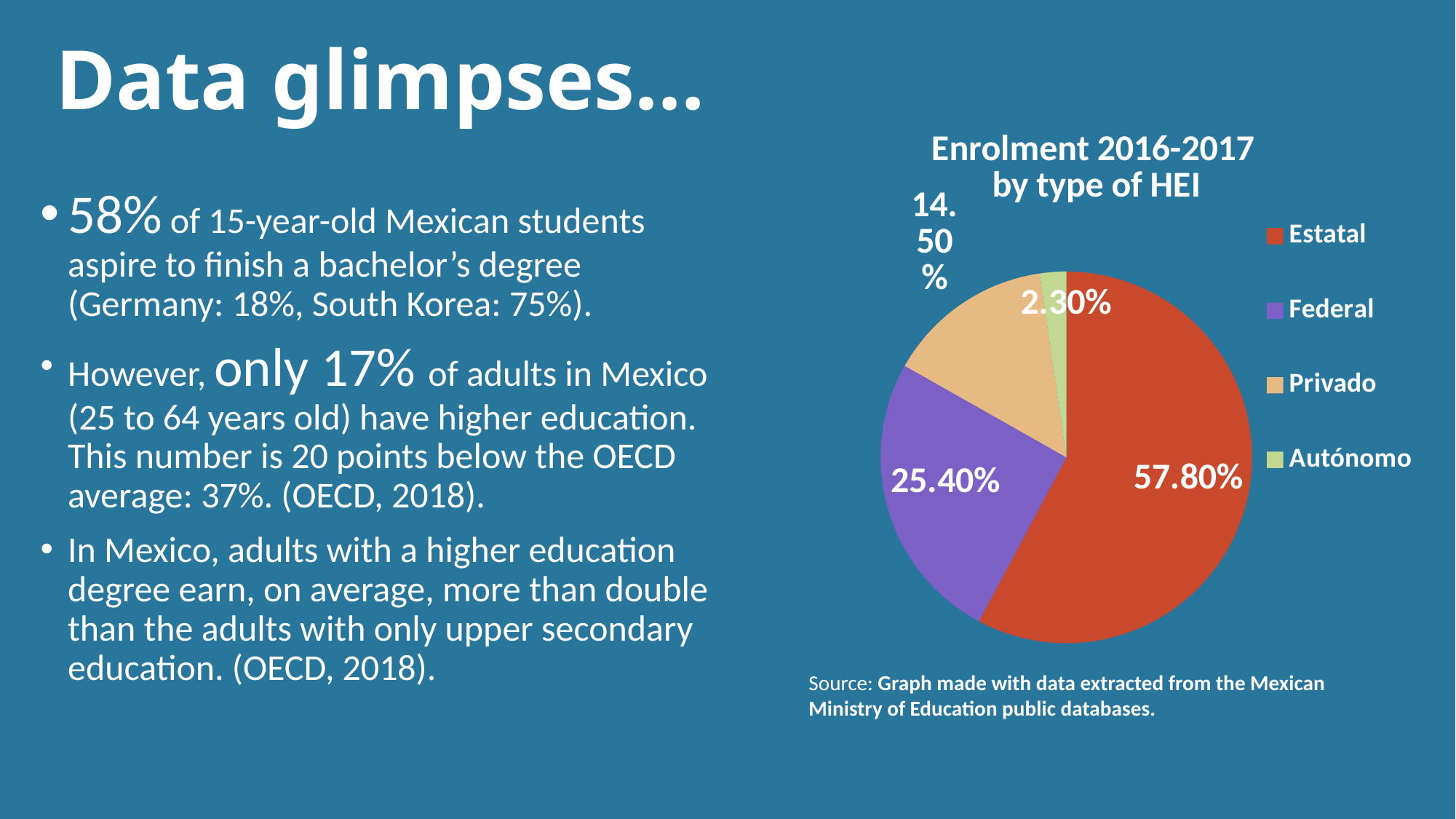
What colour represents Federal in the pie chart? Purple Which type of HEI has the largest share of enrolment? Estatal What share of enrolment is Estatal? 57.80% What share of enrolment is Autónomo? 2.30% What share of enrolment is Privado? 14.50% How many types of HEI are shown in the pie chart? 4 Which has a larger share of enrolment, Federal or Privado? Federal What kind of chart is used to show enrolment by type of HEI? Pie chart What is the difference in percentage points between the Estatal and Federal shares? 32.40% Which type of HEI has the smallest share of enrolment? Autónomo What is the title of the chart? Enrolment 2016-2017 by type of HEI What share of enrolment is Federal? 25.40%